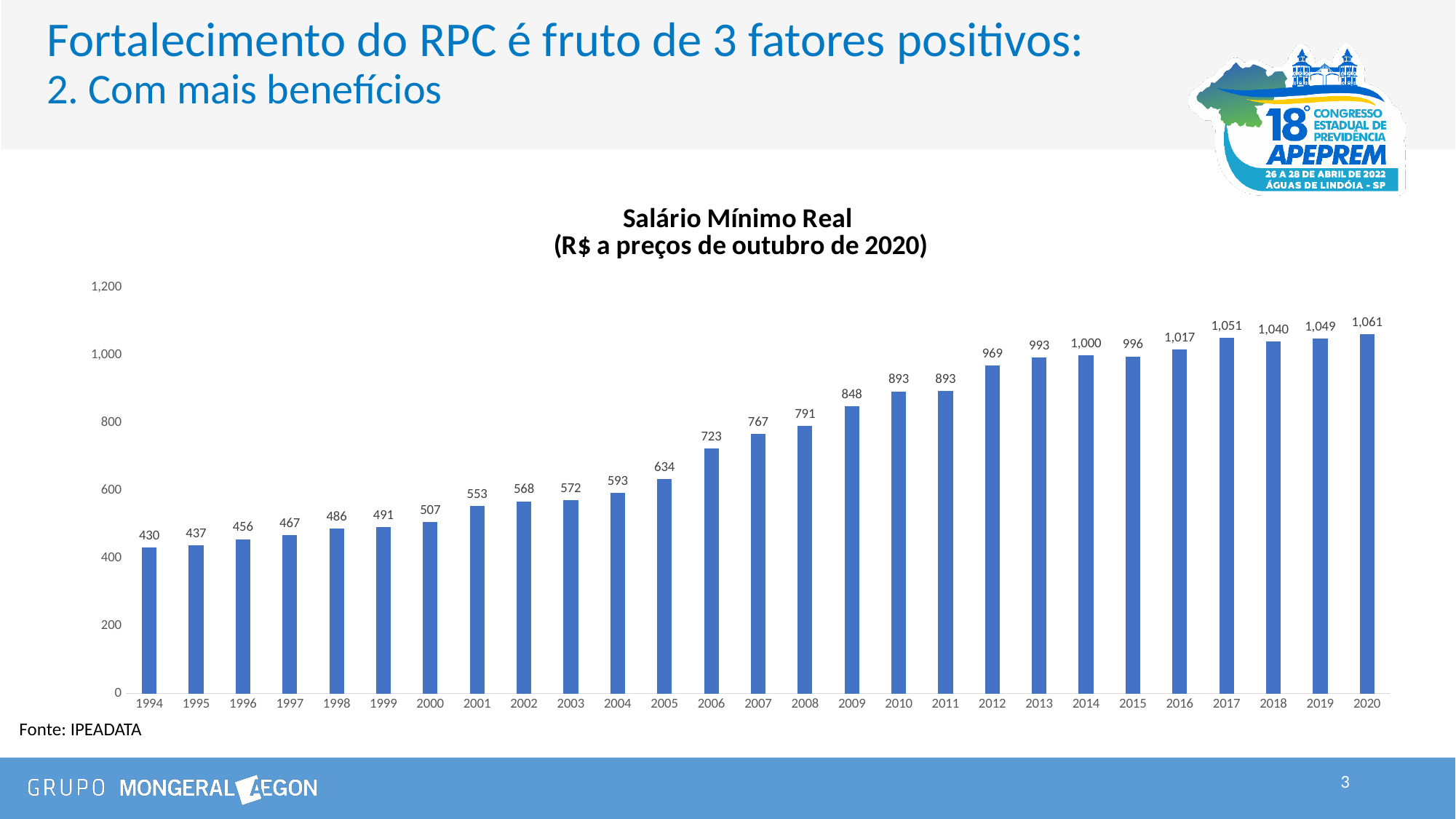
Which is larger, the value for 2017 or the value for 2018? 2017 Do the values generally rise or fall from 1994 to 2020? Rise Which year has the lowest value? 1994 How many years are shown on the x axis? 27 What is the value for 2017? 1,051 What is the title of the chart? Salário Mínimo Real (R$ a preços de outubro de 2020) Which year has the highest value? 2020 What is the difference between the values for 2020 and 1994? 631 Is the value for 2012 greater or less than 800? greater What is the value for 2010? 893 What kind of chart is this? Bar chart What is the value for 1994? 430